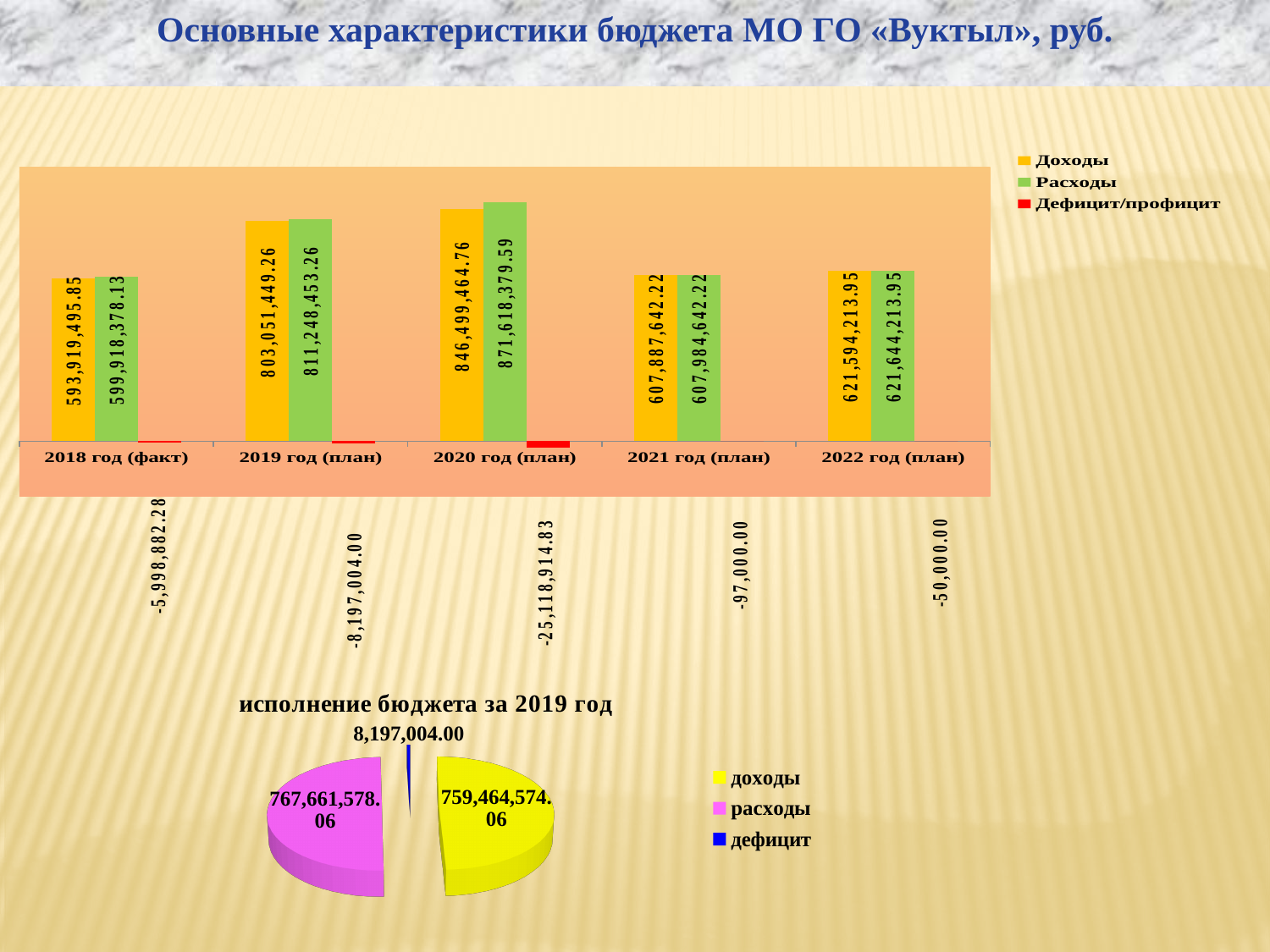
How many year categories are shown in the top bar chart? 5 In the top bar chart, what is the difference between Расходы and Доходы for 2021 год (план)? 97,000.00 How many series does the legend of the top bar chart list? 3 In the pie chart 'исполнение бюджета за 2019 год', which slice is the smallest? дефицит What kind of chart is the chart titled 'исполнение бюджета за 2019 год'? Pie chart In the top bar chart, which year has the highest Доходы? 2020 год (план) In the top bar chart, which year has the lowest Расходы? 2018 год (факт) In the top bar chart, what is the Дефицит/профицит value for 2019 год (план)? -8,197,004.00 In the top bar chart, what is the value of Доходы for 2018 год (факт)? 593,919,495.85 In the top bar chart, what is the value of Расходы for 2020 год (план)? 871,618,379.59 In the top bar chart, which is larger for 2019 год (план): Доходы or Расходы? Расходы In the pie chart 'исполнение бюджета за 2019 год', what is the value of расходы? 767,661,578.06